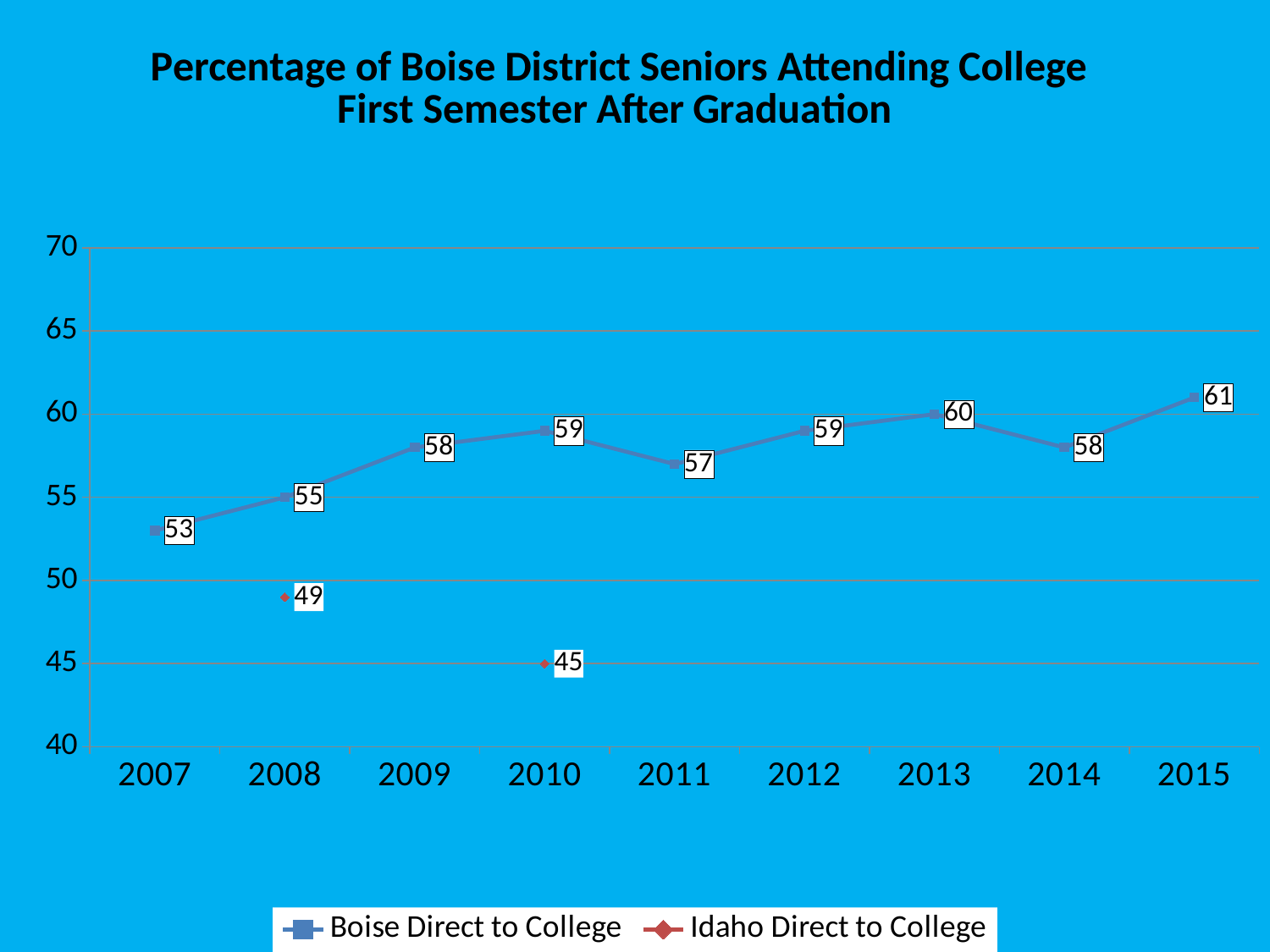
What is the Boise Direct to College value for 2007? 53 What is the Idaho Direct to College value for 2008? 49 What kind of chart is shown on the slide? Line chart How many series does the legend list? 2 In which year is the Boise Direct to College value highest? 2015 Does the Boise Direct to College value rise or fall from 2013 to 2014? Fall In which year is the Boise Direct to College value lowest? 2007 What is the Boise Direct to College value for 2015? 61 In 2008, which series has the larger value, Boise Direct to College or Idaho Direct to College? Boise Direct to College How many years are shown on the x axis? 9 What is the Idaho Direct to College value for 2010? 45 What is the difference between the Boise Direct to College values for 2015 and 2007? 8